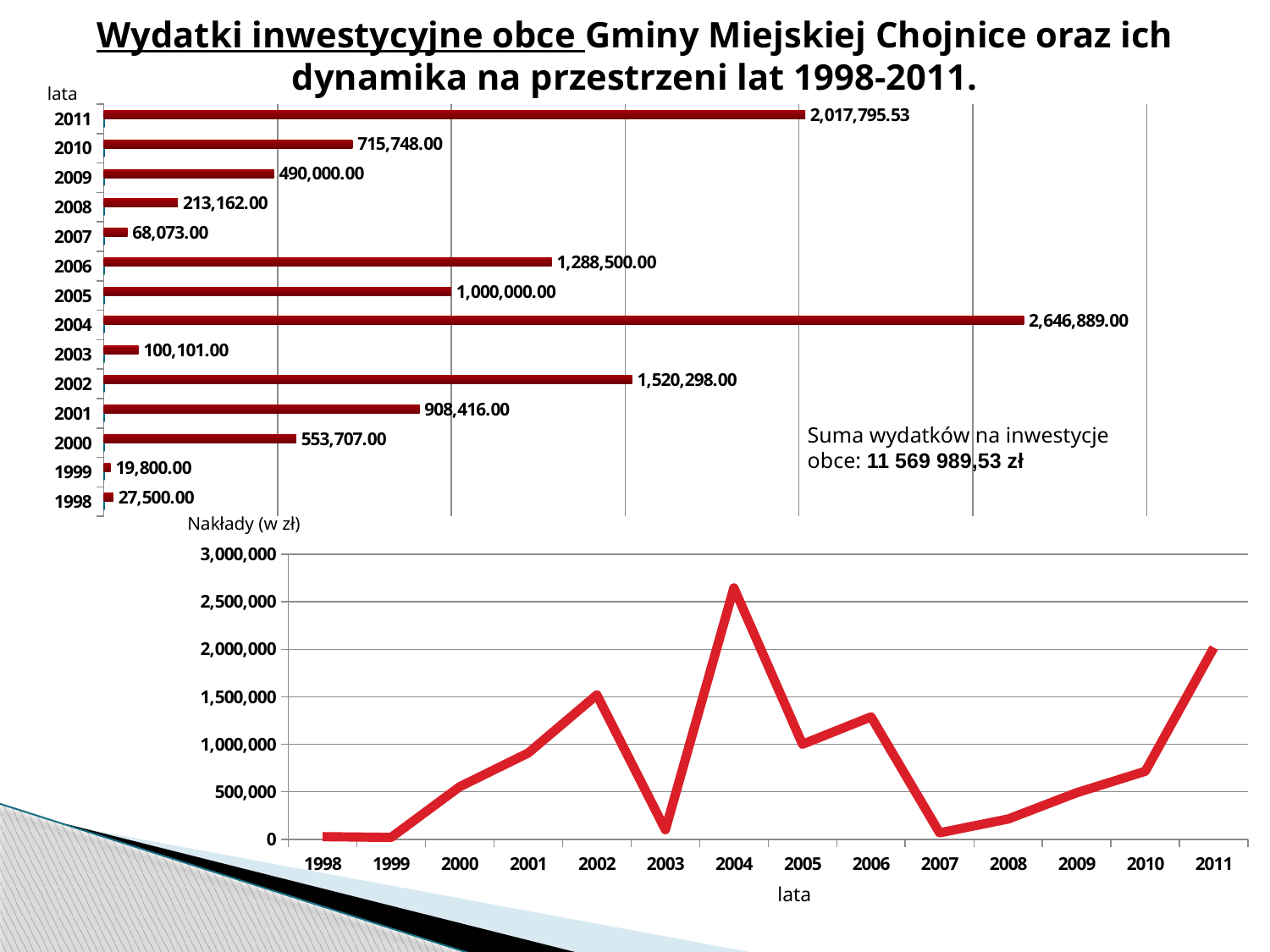
In the bottom line chart, do the values rise or fall from 2007 to 2011? rise In the top bar chart, which year has the lowest value? 1999 In the top bar chart, what is the value for 2004? 2,646,889.00 How many years are shown in the top bar chart? 14 What kind of chart is the bottom chart on the slide? line chart In the bottom line chart, is the value for 2003 greater or less than 500,000? less In the top bar chart, which year has the highest value? 2004 What kind of chart is the top chart on the slide? bar chart In the top bar chart, what is the value for 2011? 2,017,795.53 In the top bar chart, what is the difference between the values for 2006 and 2005? 288,500.00 In the top bar chart, which is larger, the value for 2002 or the value for 2006? 2002 In the top bar chart, what is the value for 1999? 19,800.00